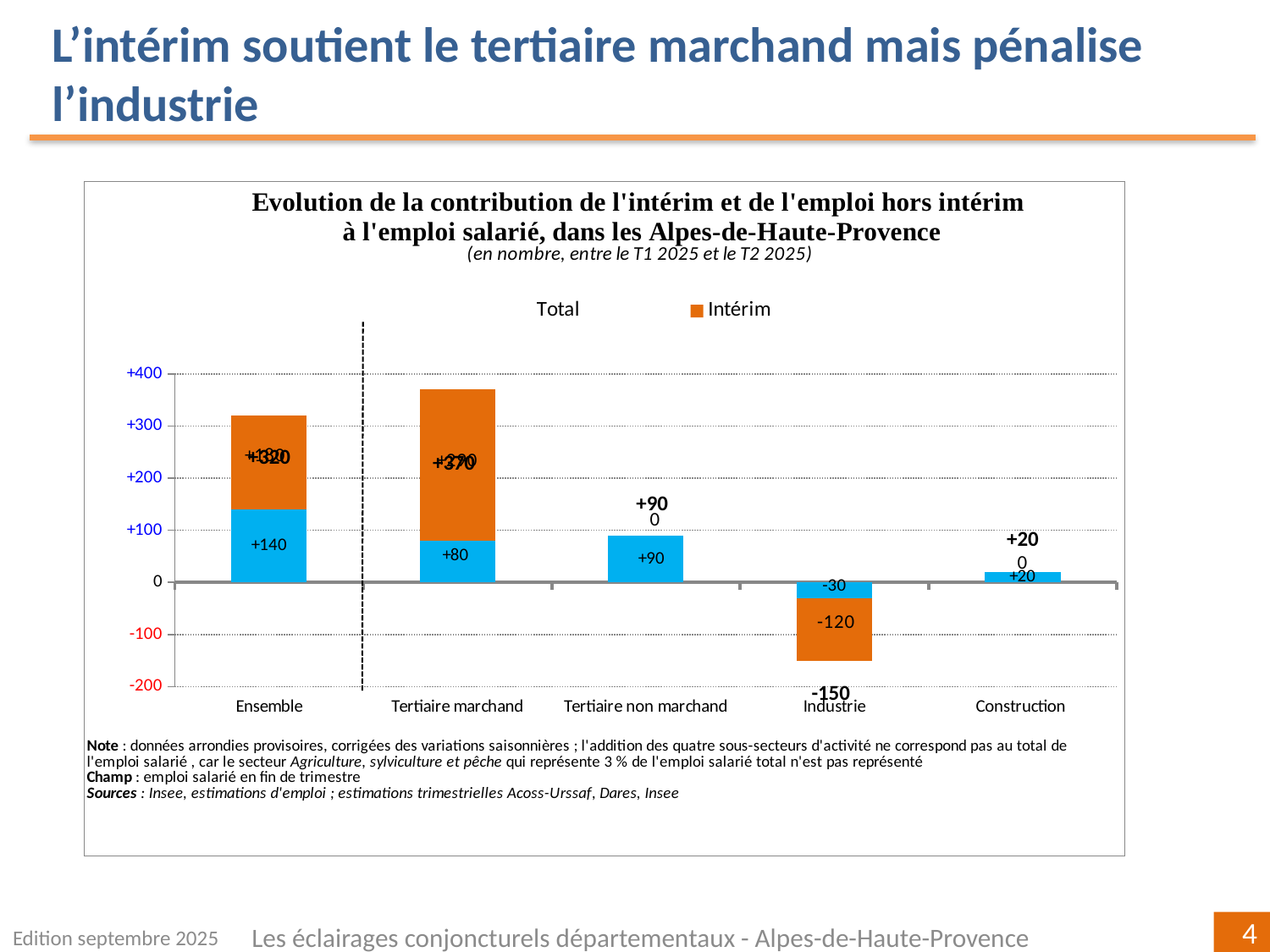
What is the total value printed for Construction? +20 Which category has the lowest total value? Industrie What is the Intérim (orange) value for Industrie? -120 How many categories are shown on the x axis? 5 What value is printed on the blue bar segment for Industrie? -30 What kind of chart is shown on the slide? Bar chart Which category has the highest total value? Tertiaire marchand What is the Intérim value printed for Construction? 0 Is the total for Ensemble greater or less than +300? greater What value is printed on the blue bar segment for Tertiaire non marchand? +90 What is the difference between the blue segment value (-30) and the Intérim value (-120) for Industrie? 90 What is the total value printed above/below the Industrie bar? -150